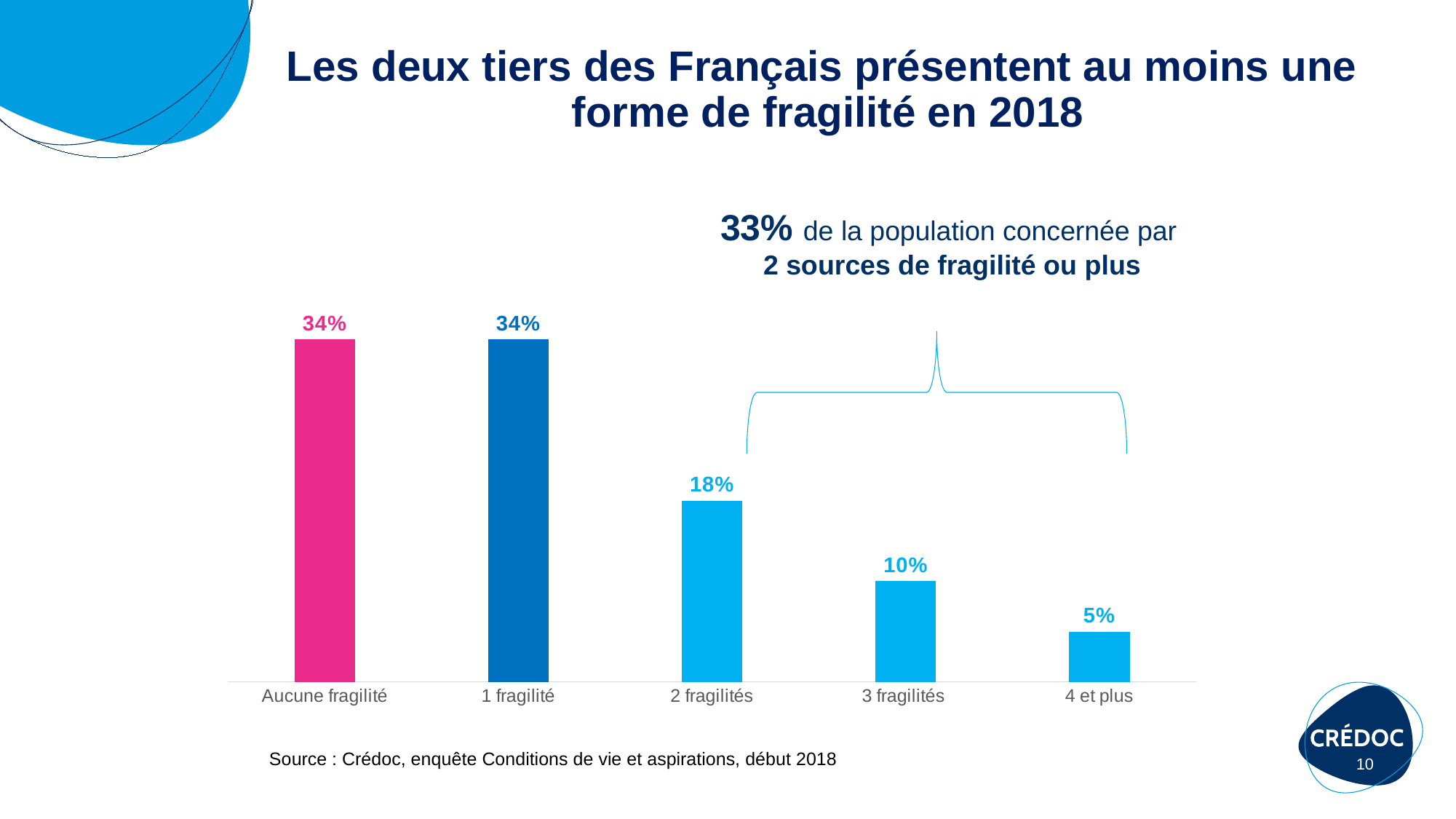
How many categories are shown on the x axis? 5 What is the value for "Aucune fragilité"? 34% What is the value for "3 fragilités"? 10% Which is larger, the value for "2 fragilités" or the value for "4 et plus"? 2 fragilités Do the values rise or fall from "1 fragilité" to "4 et plus" along the x axis? Fall What is the value for "2 fragilités"? 18% What colour is the bar for "Aucune fragilité"? Pink What is the value for "4 et plus"? 5% What kind of chart is shown on the slide? Bar chart What is the difference between the values for "1 fragilité" and "4 et plus"? 29% Which category has the lowest value? 4 et plus What is the difference between the values for "2 fragilités" and "3 fragilités"? 8%